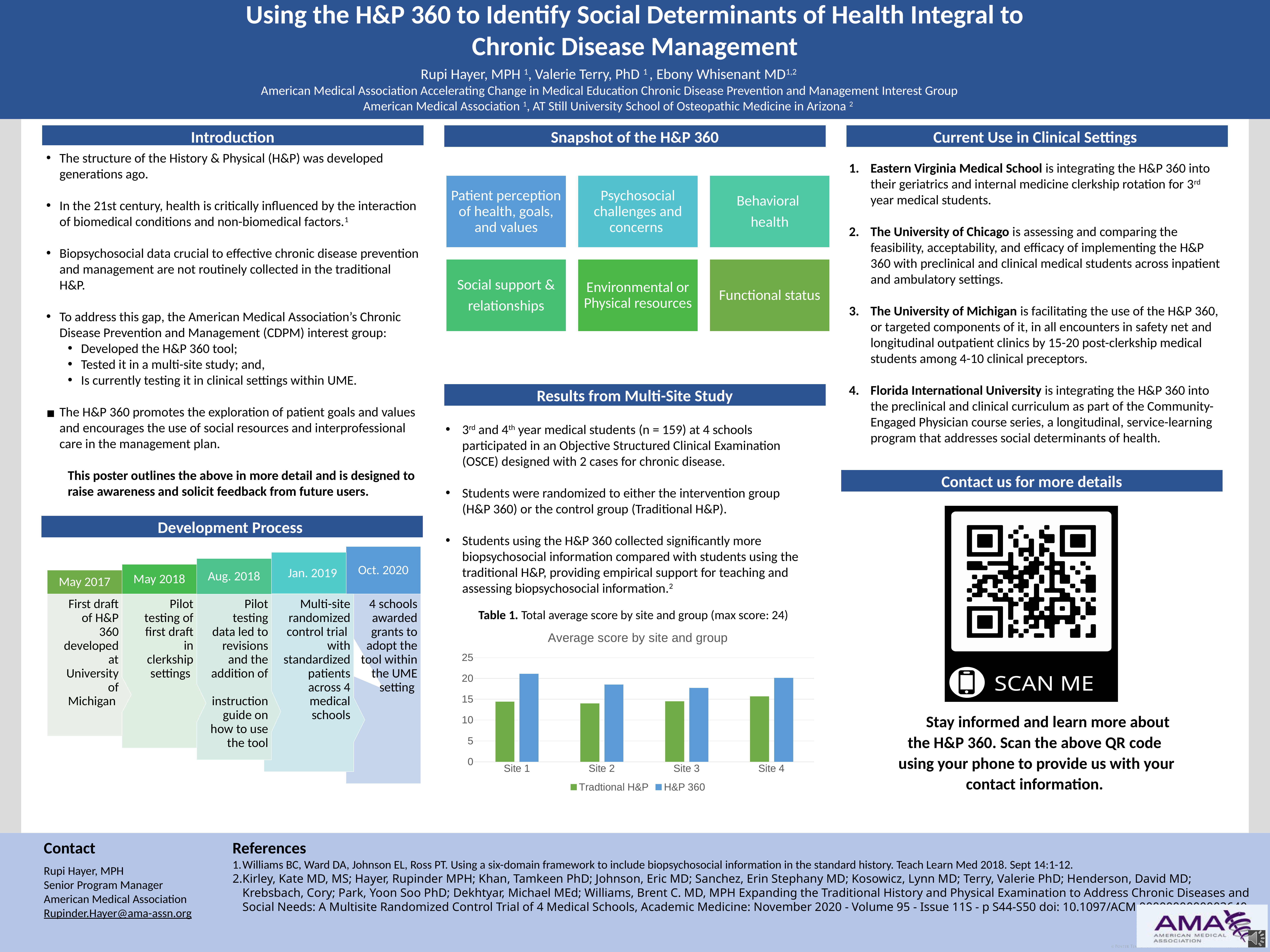
What kind of chart is shown under 'Results from Multi-Site Study'? Bar chart How many series does the legend of the 'Average score by site and group' chart list? 2 What is the title of the chart in the 'Results from Multi-Site Study' section? Average score by site and group In the 'Average score by site and group' chart, which group has the larger value at Site 1, Tradtional H&P or H&P 360? H&P 360 How many sites are shown on the x axis of the 'Average score by site and group' chart? 4 What are the two series named in the legend of the 'Average score by site and group' chart? Tradtional H&P and H&P 360 In the 'Average score by site and group' chart, which site has the highest Tradtional H&P value? Site 4 In the 'Average score by site and group' chart, is the H&P 360 value for Site 1 greater or less than 20? greater In the 'Average score by site and group' chart, which group has the larger value at Site 4, Tradtional H&P or H&P 360? H&P 360 In the 'Average score by site and group' chart, is the H&P 360 value for Site 3 greater or less than 15? greater In the 'Average score by site and group' chart, is the Tradtional H&P value for Site 2 greater or less than 15? less